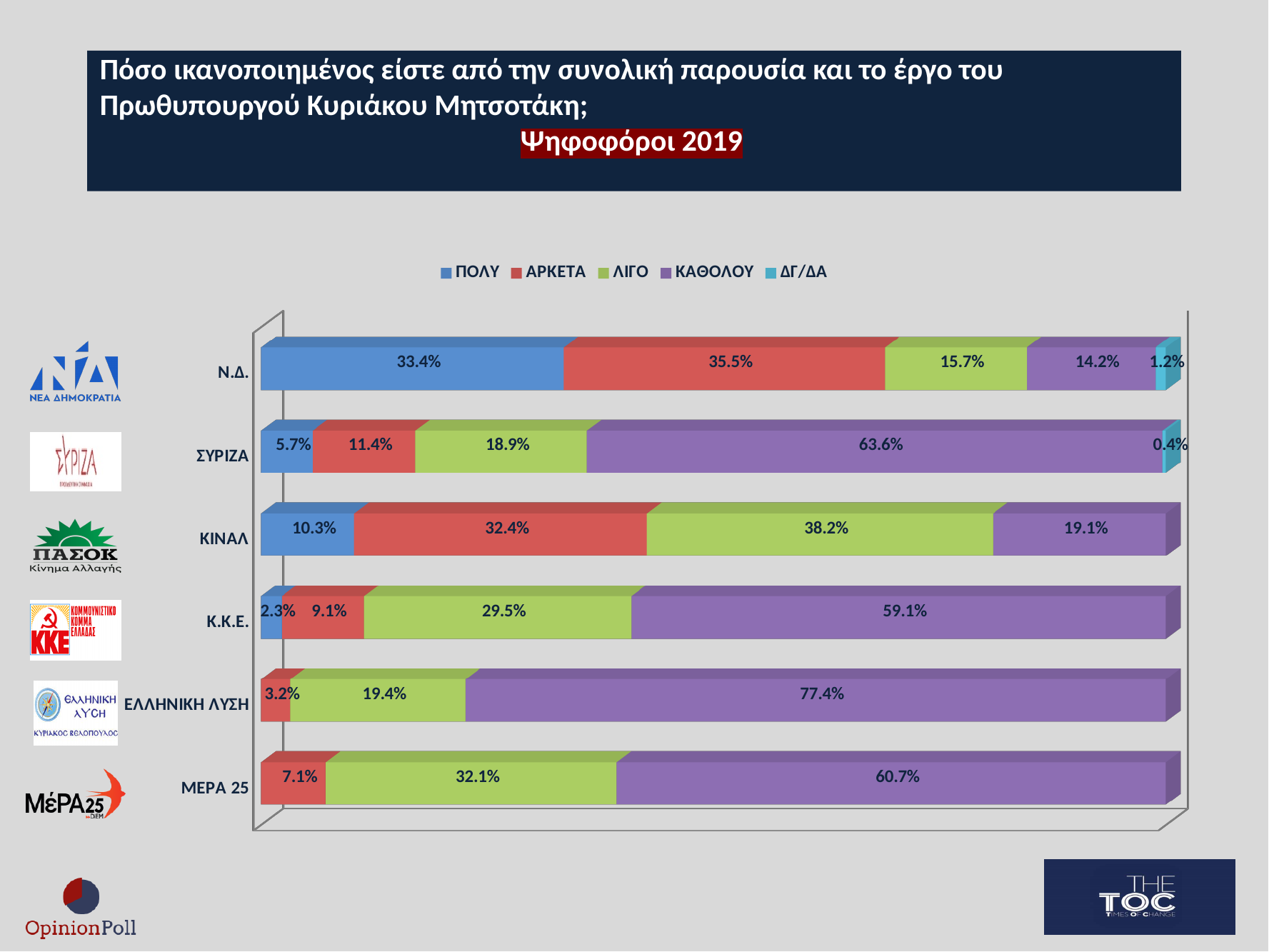
What is the ΚΑΘΟΛΟΥ value for ΣΥΡΙΖΑ? 63.6% What is the ΛΙΓΟ value for ΚΙΝΑΛ? 38.2% What is the ΚΑΘΟΛΟΥ value for ΕΛΛΗΝΙΚΗ ΛΥΣΗ? 77.4% Which colour represents ΚΑΘΟΛΟΥ in the legend? Purple How many series does the legend list? 5 Which is larger: the ΚΑΘΟΛΟΥ value for Κ.Κ.Ε. or the ΚΑΘΟΛΟΥ value for ΜΕΡΑ 25? ΜΕΡΑ 25 Which party has the lowest ΠΟΛΥ value among those with a ΠΟΛΥ label? Κ.Κ.Ε. How many parties are shown on the chart? 6 What is the difference between the ΑΡΚΕΤΑ value for Ν.Δ. and the ΑΡΚΕΤΑ value for ΚΙΝΑΛ? 3.1% Which party has the highest ΚΑΘΟΛΟΥ value? ΕΛΛΗΝΙΚΗ ΛΥΣΗ What kind of chart is shown on the slide? Stacked bar chart What percentage of Ν.Δ. voters answered ΠΟΛΥ? 33.4%